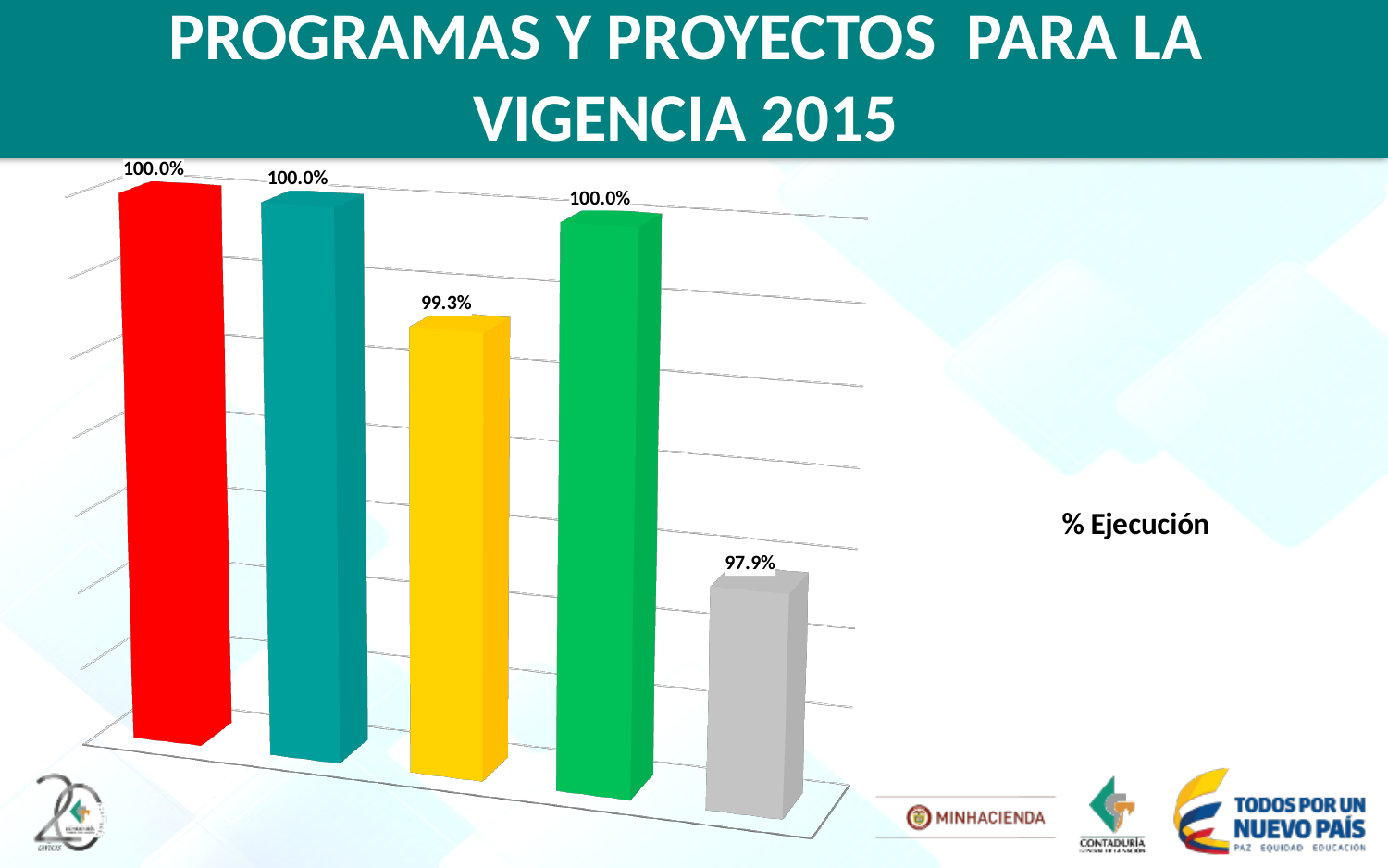
What value is labelled on the green bar (fourth from the left)? 100.0% What is the difference between the value of the yellow bar and the value of the grey bar? 1.4% Which is larger, the value of the yellow bar or the value of the grey bar? the yellow bar Which bar has the lowest value in the chart? the grey bar (fifth from the left), 97.9% How many bars are labelled 100.0%? 3 What type of chart is shown on the slide? bar chart What value is labelled on the red bar (first from the left)? 100.0% What value is labelled on the grey bar (fifth from the left)? 97.9% What is the difference between the value of the red bar and the value of the grey bar? 2.1% What value is labelled on the yellow bar (third from the left)? 99.3% How many bars are plotted in the chart? 5 What is the legend entry shown next to the chart? % Ejecución